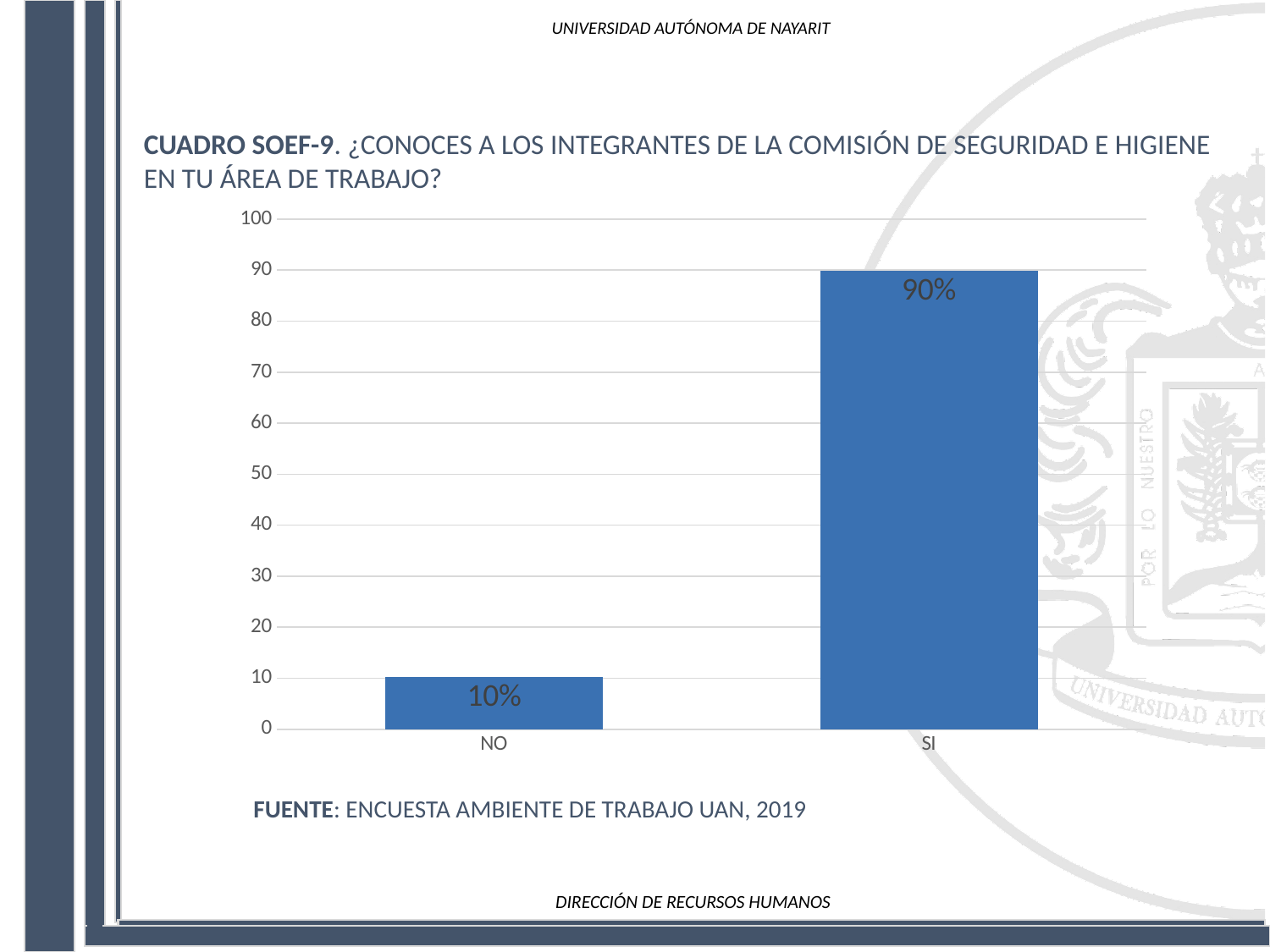
Which category has the highest value? SI Which category has the lowest value? NO Is the value for NO greater or less than 20? less What is the value for SI? 90% Which is larger, the value for NO or the value for SI? SI Is the value for SI greater or less than 50? greater What kind of chart is shown on the slide? bar chart How many categories are shown on the x axis? 2 What is the difference between the values for SI and NO? 80% What source is cited below the chart? ENCUESTA AMBIENTE DE TRABAJO UAN, 2019 What is the value for NO? 10% What is the maximum value shown on the y axis? 100